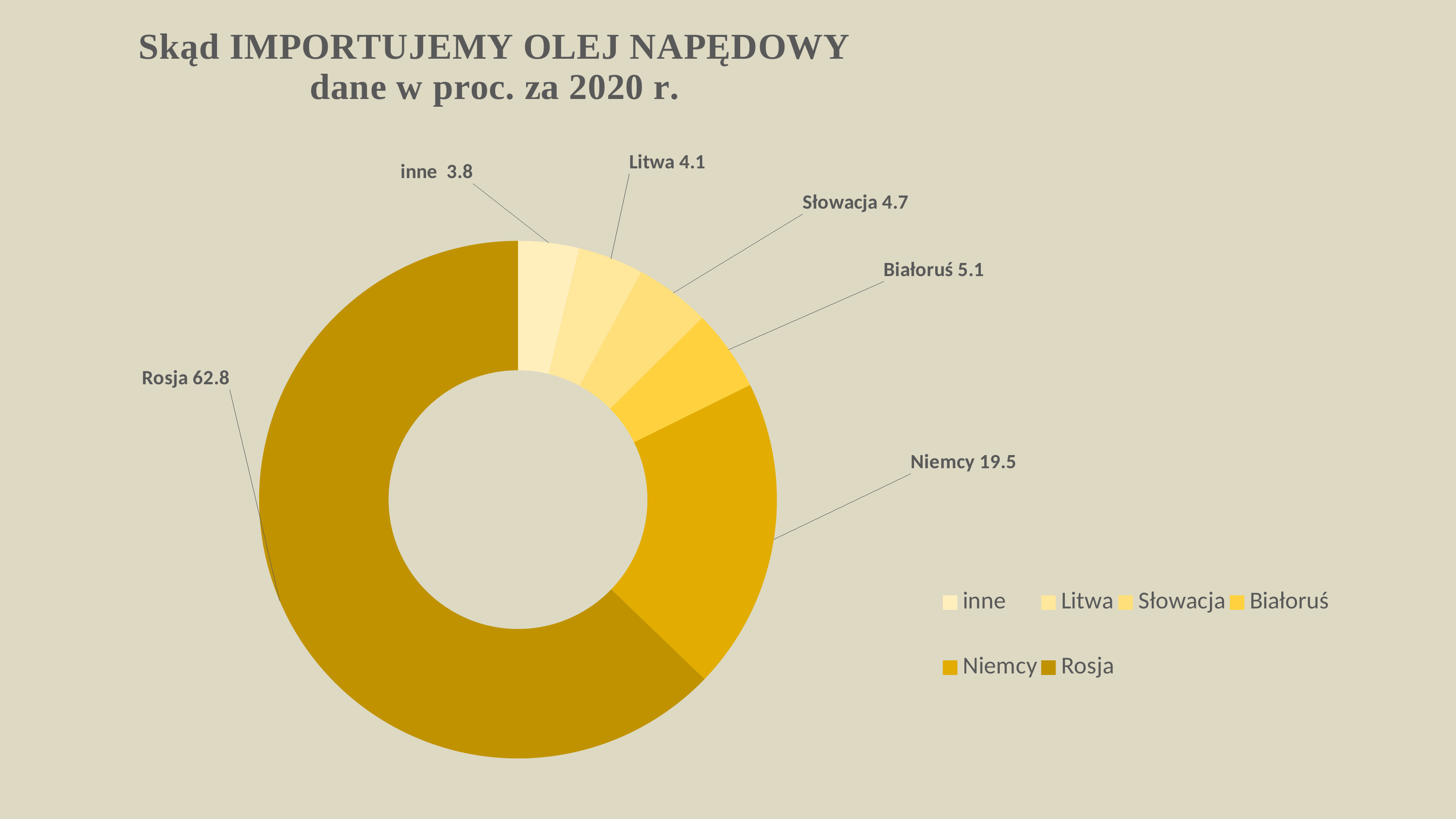
What kind of chart is shown on the slide? Doughnut chart Which category has the smallest share? inne What is the difference between the values for Rosja and Niemcy? 43.3 What is the value for Litwa? 4.1 What is the title of the chart? Skąd IMPORTUJEMY OLEJ NAPĘDOWY dane w proc. za 2020 r. What is the value for Rosja? 62.8 Which category is shown in the darkest colour in the legend? Rosja What is the value for Białoruś? 5.1 How many categories are shown in the chart? 6 What is the value for Niemcy? 19.5 Which category has the largest share? Rosja Which is larger, Słowacja or Litwa? Słowacja